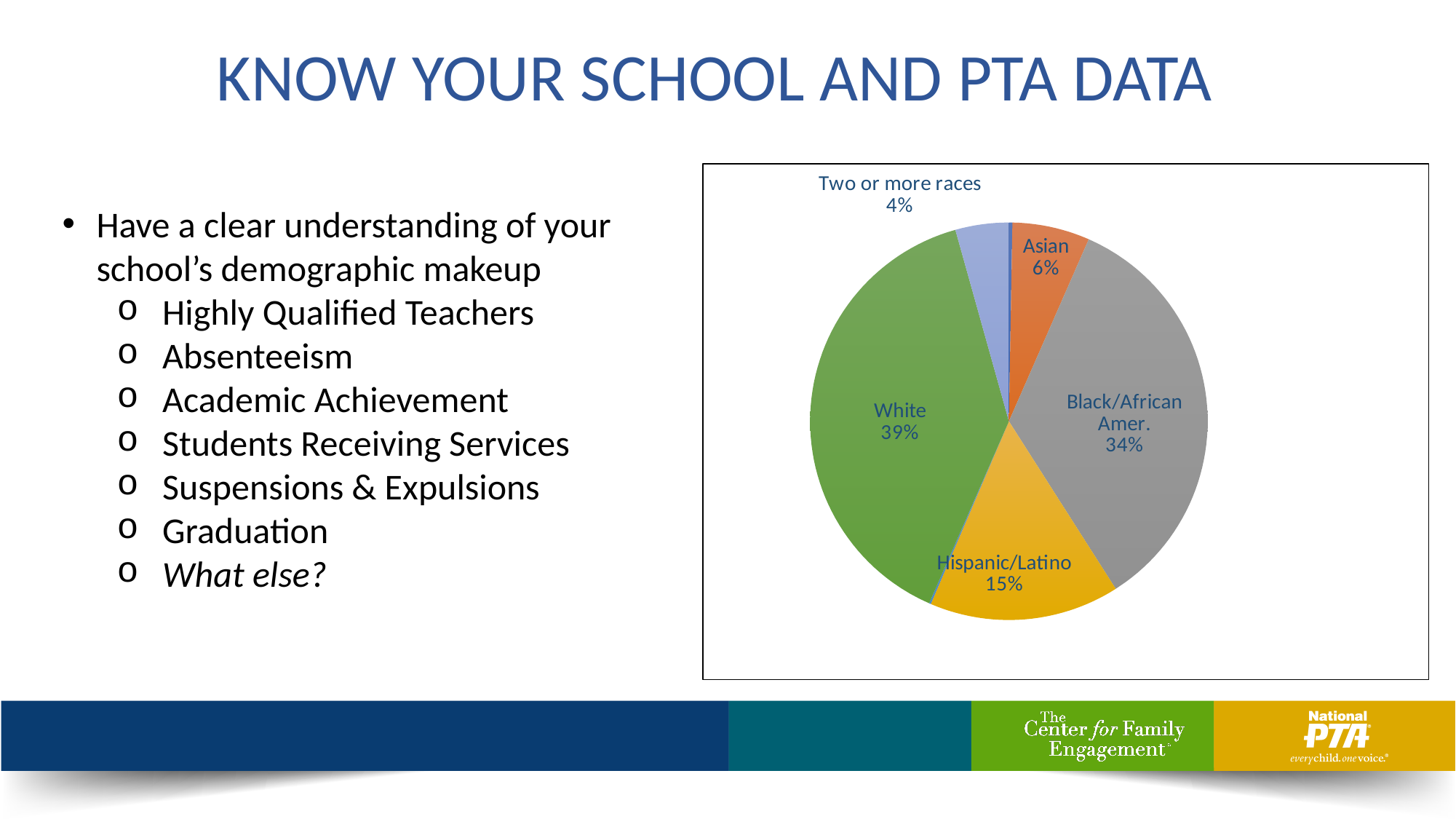
What percentage of the pie is labelled Asian? 6% Which category has the largest slice of the pie? White What percentage of the pie is labelled Black/African Amer.? 34% Which slice is larger, Hispanic/Latino or Asian? Hispanic/Latino What percentage of the pie is labelled Hispanic/Latino? 15% What is the difference in percentage points between the White and Black/African Amer. slices? 5 What colour is the White slice of the pie? green What percentage of the pie is labelled White? 39% What kind of chart is shown on the slide? pie chart What percentage of the pie is labelled Two or more races? 4%